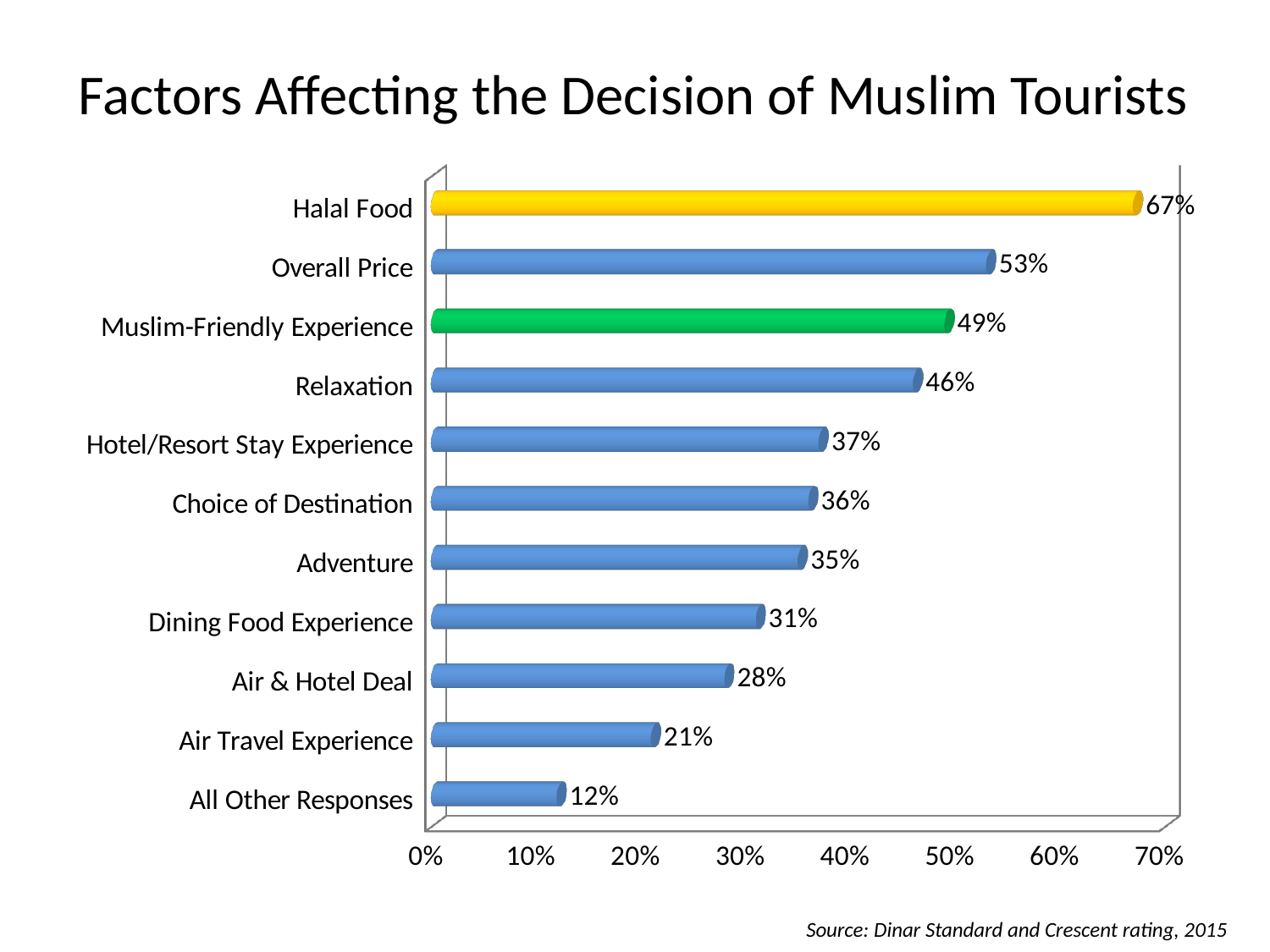
What is the difference between Halal Food and Overall Price? 14% What is the title of the chart? Factors Affecting the Decision of Muslim Tourists What is the value for Air & Hotel Deal? 28% What kind of chart is shown on the slide? Bar chart What is the value for Muslim-Friendly Experience? 49% What is the difference between Relaxation and Air Travel Experience? 25% What is the value for Halal Food? 67% Which category has the lowest value? All Other Responses Is the value for Hotel/Resort Stay Experience greater or less than 30%? greater Which factor has the highest value? Halal Food Which is larger, Dining Food Experience or Adventure? Adventure How many categories are shown in the chart? 11